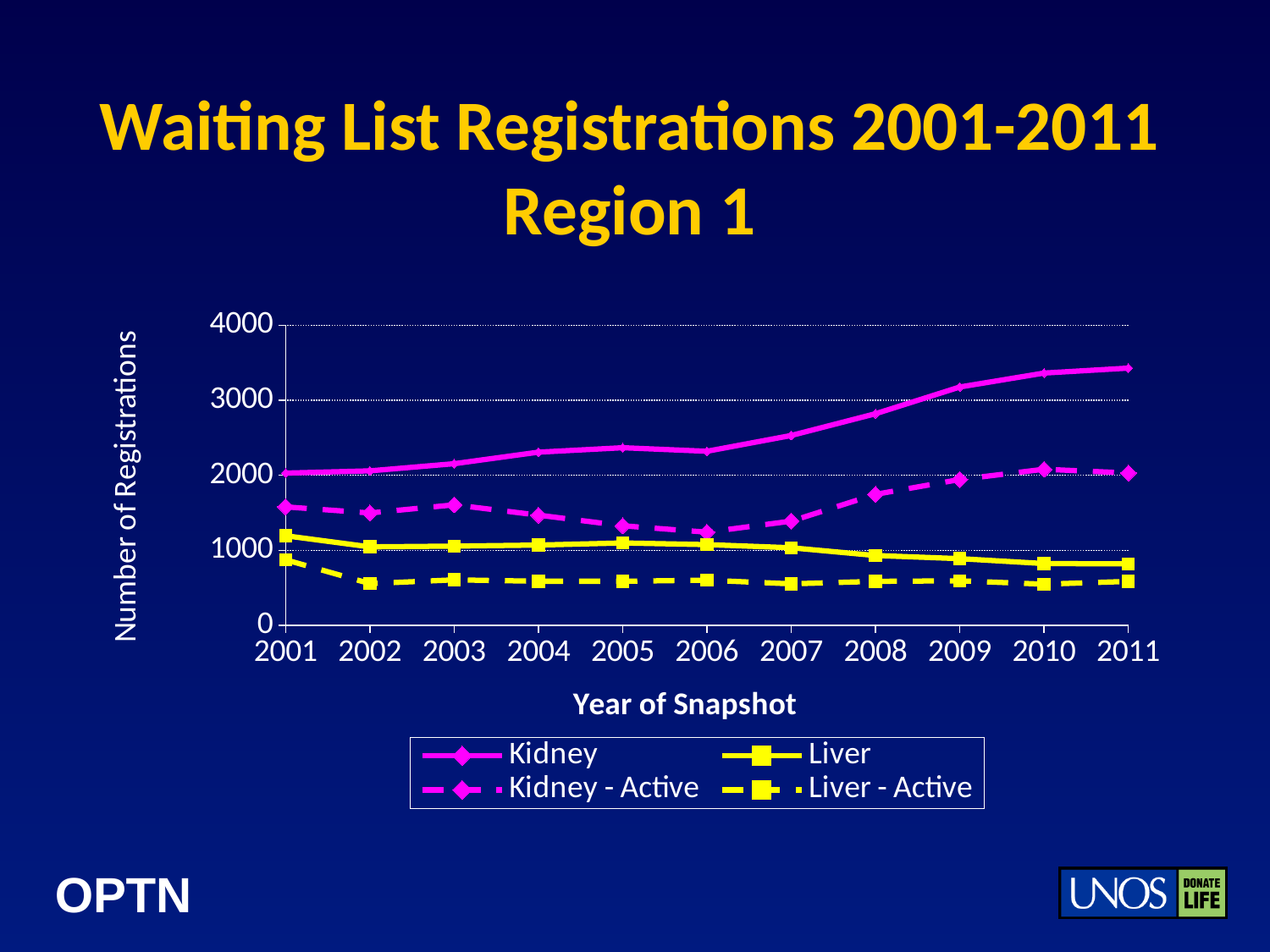
How many years are plotted along the x axis? 11 Is the value for Kidney in 2005 greater or less than 2000? greater What is the label of the x axis? Year of Snapshot What kind of chart is shown on the slide? line chart Does the Kidney series rise or fall from 2001 to 2011? rise Which series has the lowest value in 2011? Liver - Active Is the value for Liver - Active in 2002 greater or less than 1000? less Does the Liver series rise or fall from 2001 to 2011? fall How many series does the legend list? 4 Which series has the highest value in 2011? Kidney Is the value for Kidney in 2011 greater or less than 3000? greater